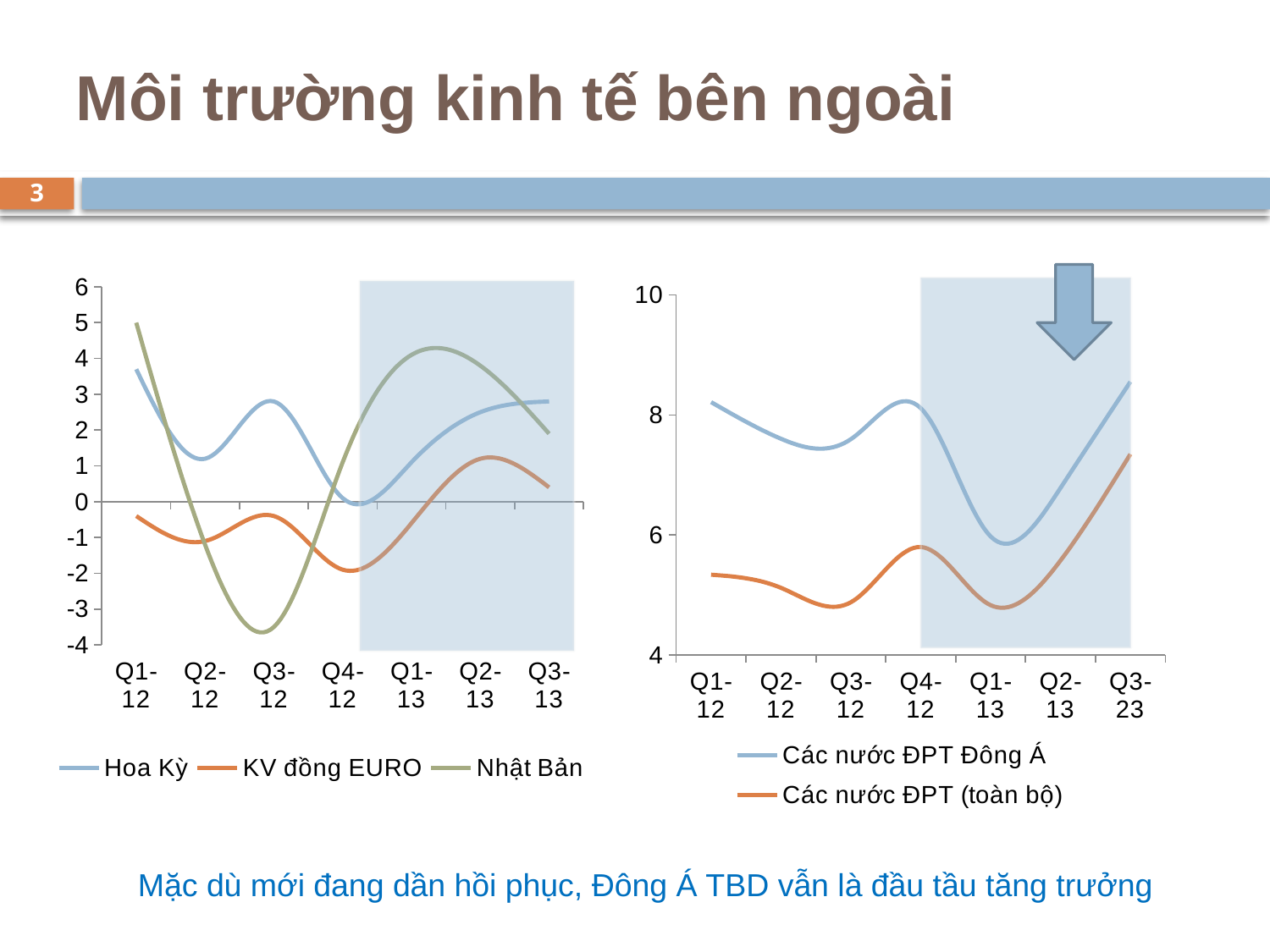
How many quarters are shown on the x axis of the right chart? 7 In the left chart, is the value for KV đồng EURO at Q4-12 greater or less than -1? less In the left chart, is the value for Nhật Bản at Q1-12 greater or less than 4? greater What kind of chart is the left chart on the slide? line chart In the right chart, do the values for Các nước ĐPT (toàn bộ) rise or fall from Q1-13 to the last quarter? rise In the left chart, at which quarter does KV đồng EURO reach its highest value? Q2-13 In the left chart, is the value for Nhật Bản at Q3-12 greater or less than -3? less How many series does the legend of the left chart list? 3 How many series does the legend of the right chart list? 2 In the left chart, at which quarter does Nhật Bản reach its lowest value? Q3-12 In the right chart, which series has the larger value at Q1-12, Các nước ĐPT Đông Á or Các nước ĐPT (toàn bộ)? Các nước ĐPT Đông Á